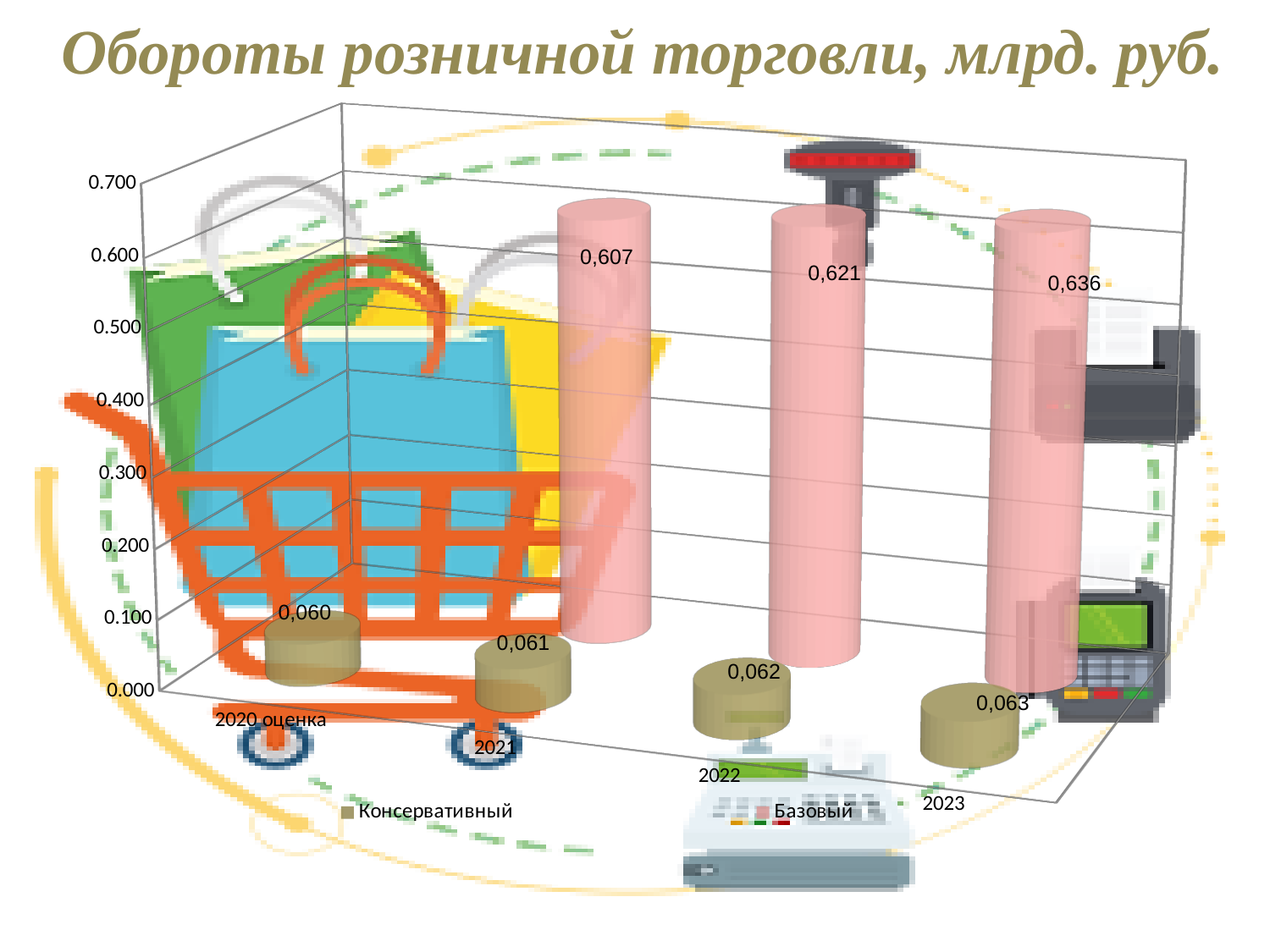
Do the Базовый values rise or fall from 2021 to 2023? Rise What is the difference between the Консервативный values for 2023 and 2020 оценка? 0,003 Which is larger for 2022: the Базовый value or the Консервативный value? Базовый How many categories are shown on the x axis? 4 What kind of chart is shown on the slide? Bar chart What is the value of the Консервативный series for 2020 оценка? 0,060 What is the value of the Базовый series for 2023? 0,636 What is the value of the Базовый series for 2022? 0,621 Which category has the lowest value in the Консервативный series? 2020 оценка How many series does the legend list? 2 What is the value of the Консервативный series for 2023? 0,063 Which year has the highest value in the Базовый series? 2023